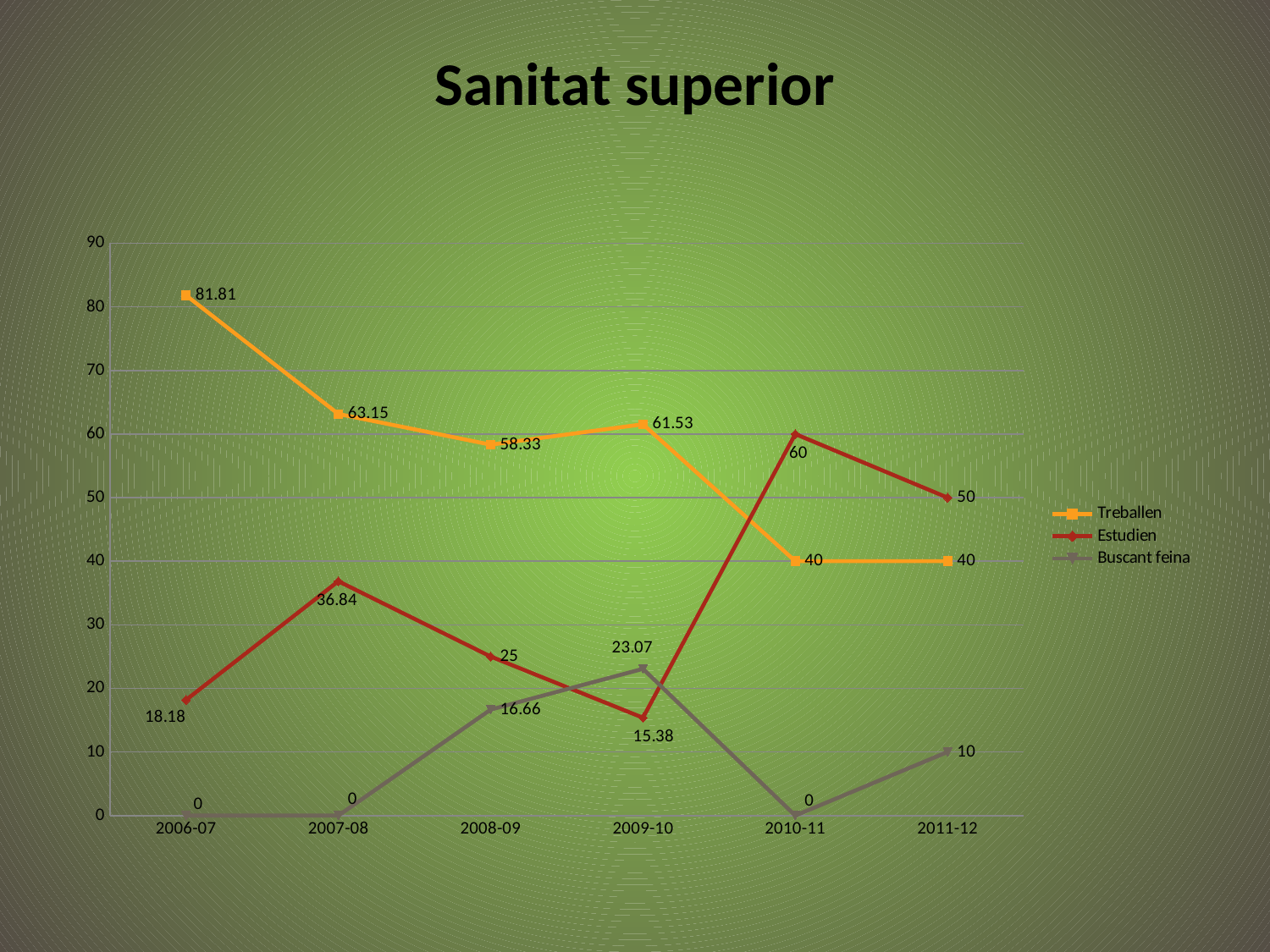
What is the value for Estudien in 2010-11? 60 In which year is the Treballen value highest? 2006-07 How many years are shown on the x axis? 6 How many series does the legend list? 3 What is the value for Buscant feina in 2009-10? 23.07 In which year is the Estudien value lowest? 2009-10 What is the value for Treballen in 2006-07? 81.81 Which is larger in 2011-12, Estudien or Treballen? Estudien What is the title of the chart? Sanitat superior What is the value for Estudien in 2007-08? 36.84 What is the difference between the Treballen value in 2006-07 and in 2007-08? 18.66 What type of chart is shown on the slide? line chart